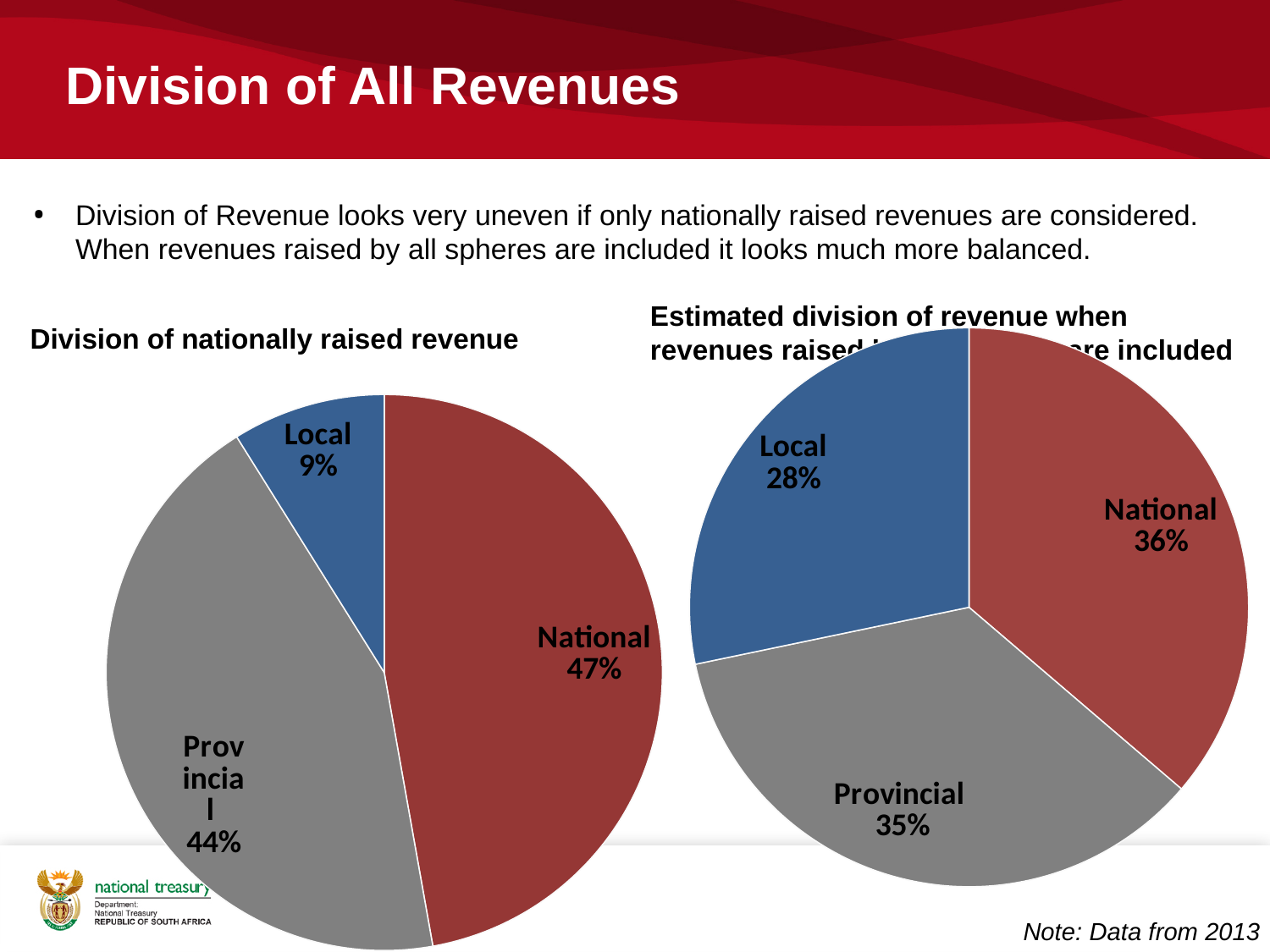
How many slices does the right-hand pie chart have? 3 In the chart titled 'Division of nationally raised revenue', what is the difference between the National and Local shares? 38% In the chart titled 'Division of nationally raised revenue', what share goes to Local? 9% In the right-hand pie chart, what is the difference between the National and Local shares? 8% In the right-hand pie chart, what share goes to Local? 28% What type of chart is used for 'Division of nationally raised revenue'? Pie chart In the chart titled 'Division of nationally raised revenue', which is larger, the Provincial share or the Local share? Provincial In the chart titled 'Division of nationally raised revenue', what share goes to National? 47% In the right-hand pie chart, which sphere has the smallest share? Local In the right-hand pie chart, what share goes to Provincial? 35% In the chart titled 'Division of nationally raised revenue', which sphere has the smallest share? Local In the chart titled 'Division of nationally raised revenue', which sphere has the largest share? National